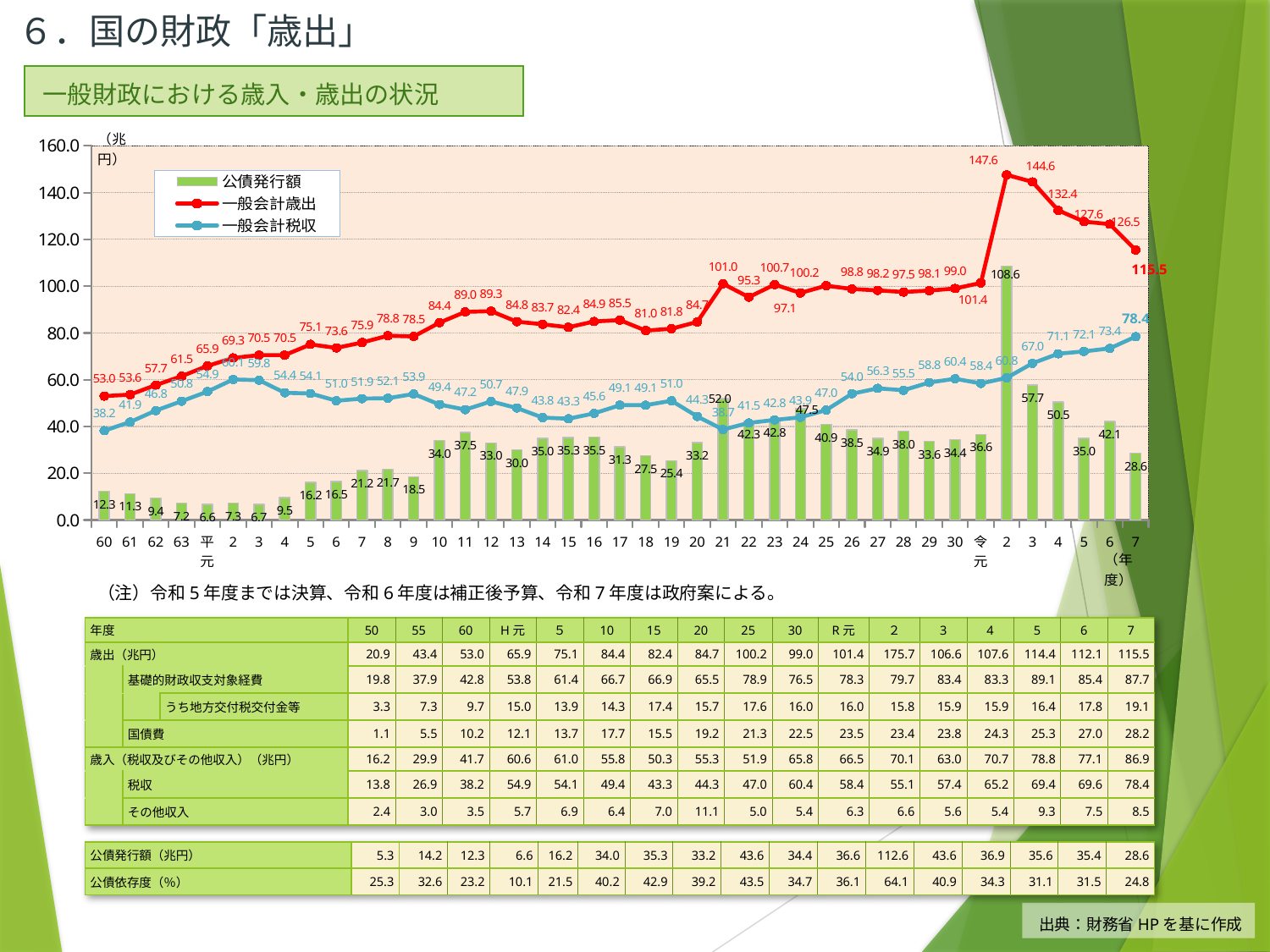
Is the value of 一般会計歳出 for 令和2 greater or less than 140? greater Which is larger, the 公債発行額 for 令和2 or for 令和7? 令和2 What is the value of 一般会計歳出 for 令和2 (令2)? 147.6 In which year is the 公債発行額 bar the tallest? 令和2 (令2) How many series does the chart legend list? 3 Which series is drawn as green bars in the chart? 公債発行額 What is the value of 公債発行額 for 昭和60 (the first year on the x axis)? 12.3 What is the difference between 一般会計歳出 and 一般会計税収 in 令和7? 37.1 What is the value of 一般会計税収 for 令和7 (令7)? 78.4 What kind of chart is shown on the slide? A combined bar and line chart In which year does 一般会計歳出 reach its highest value? 令和2 (令2) Does 一般会計歳出 rise or fall from 令和2 to 令和7? fall